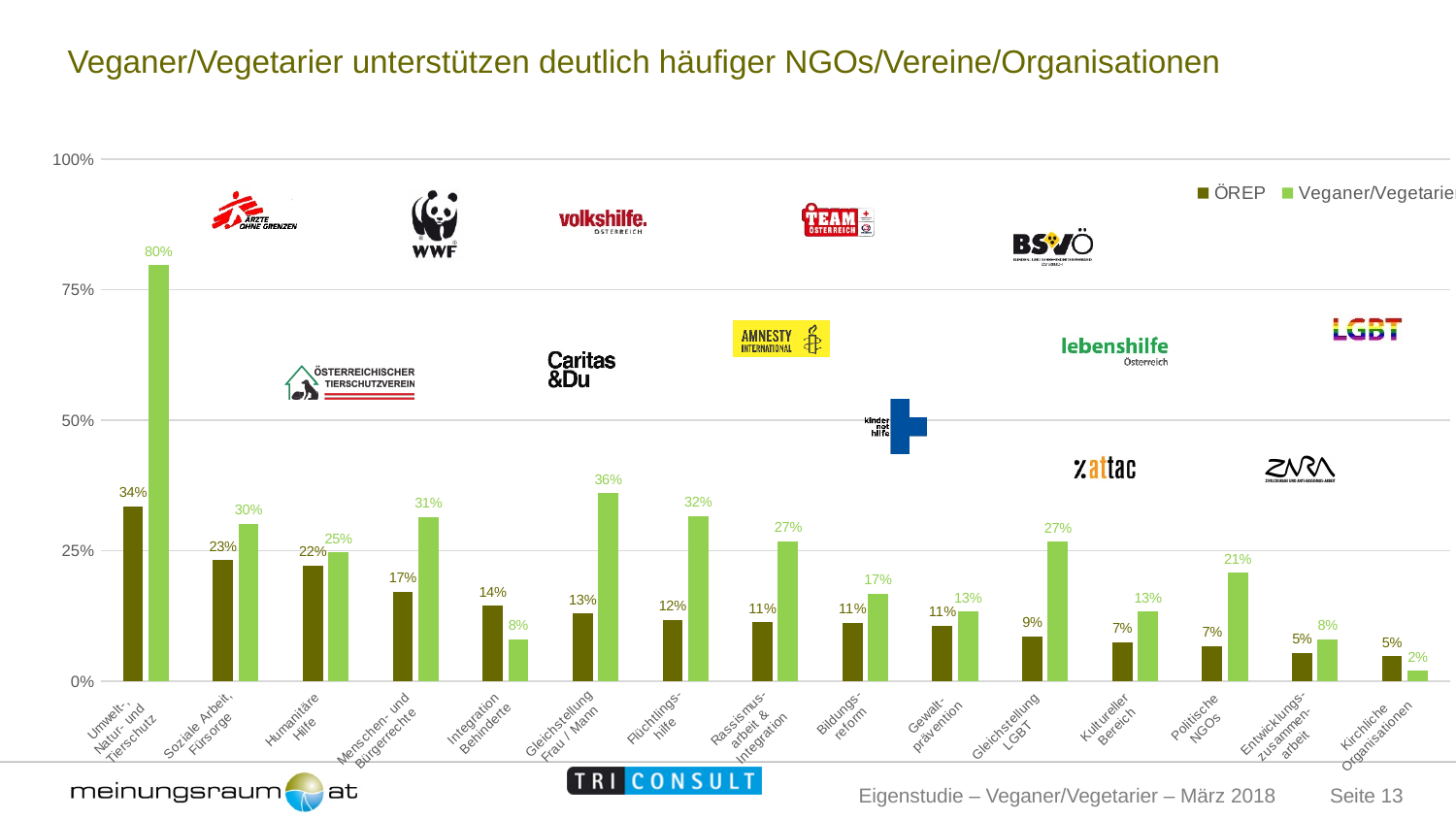
Which category has the highest ÖREP value? Umwelt-, Natur- und Tierschutz What is the Veganer/Vegetarier value for Gleichstellung Frau / Mann? 36% What is the difference between the Veganer/Vegetarier and ÖREP values for Umwelt-, Natur- und Tierschutz? 46% Is the Veganer/Vegetarier value for Umwelt-, Natur- und Tierschutz greater or less than 75%? greater How many series does the legend list? 2 For Integration Behinderte, which series has the larger value, ÖREP or Veganer/Vegetarier? ÖREP Which category has the lowest Veganer/Vegetarier value? Kirchliche Organisationen How many categories are shown on the x axis? 15 What percentage of Veganer/Vegetarier support Umwelt-, Natur- und Tierschutz? 80% What kind of chart is shown on the slide? bar chart What is the ÖREP value for Flüchtlingshilfe? 12% What is the difference between the Veganer/Vegetarier and ÖREP values for Gleichstellung LGBT? 18%